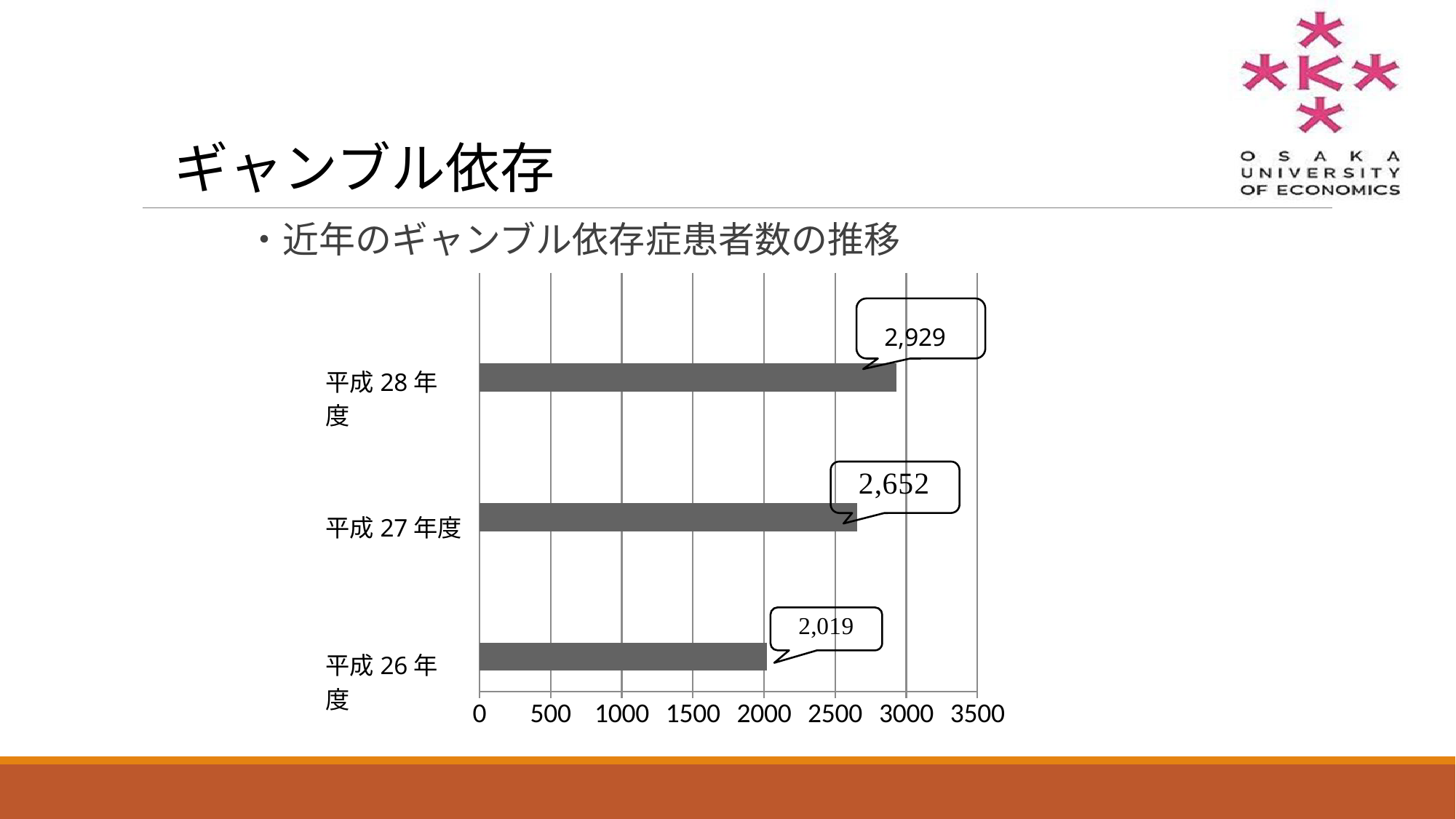
Which is larger, the value for 平成27年度 or 平成26年度? 平成27年度 Do the values rise or fall from 平成26年度 to 平成28年度? rise Is the value for 平成28年度 greater or less than 2500? greater What kind of chart is shown on the slide? bar chart Which year has the highest value? 平成28年度 What is the value for 平成26年度? 2,019 What is the value for 平成28年度? 2,929 Which year has the lowest value? 平成26年度 What is the value for 平成27年度? 2,652 How many years are shown in the chart? 3 What is the difference between the values for 平成28年度 and 平成27年度? 277 What is the difference between the values for 平成27年度 and 平成26年度? 633